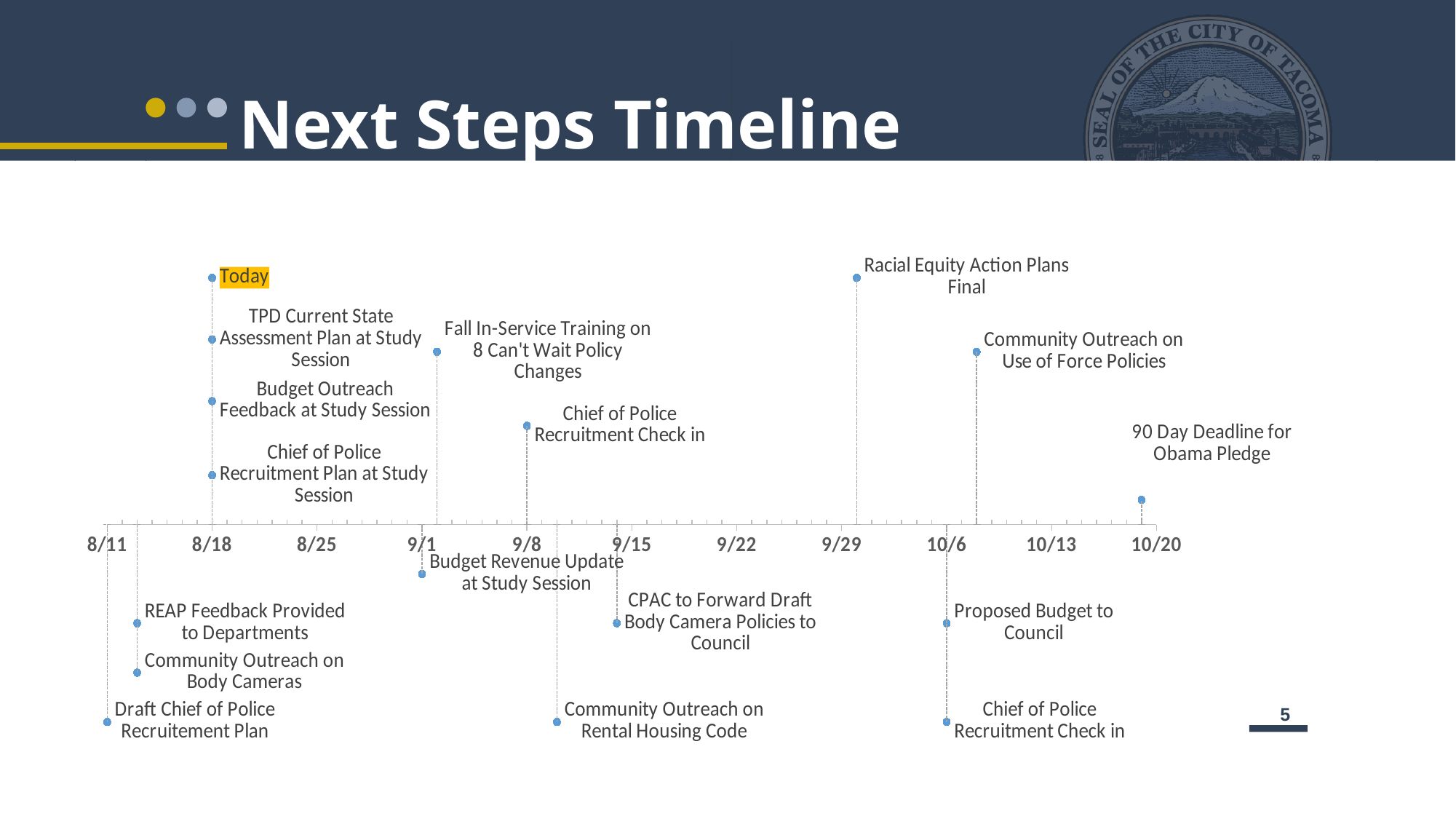
On what date is 'Proposed Budget to Council' placed? 10/6 On what date is 'Draft Chief of Police Recruitement Plan' placed? 8/11 Which comes earlier on the timeline, 'Racial Equity Action Plans Final' or 'Community Outreach on Use of Force Policies'? Racial Equity Action Plans Final On what date is 'Budget Revenue Update at Study Session' placed? 9/1 What kind of chart is shown on the slide? Timeline chart How many date labels are shown along the timeline axis? 11 Which event is the last one on the timeline? 90 Day Deadline for Obama Pledge What is the title of the chart? Next Steps Timeline What are the first and last dates labelled on the timeline axis? 8/11 and 10/20 Which event is the earliest on the timeline? Draft Chief of Police Recruitement Plan On what date is the 'Today' marker placed on the timeline? 8/18